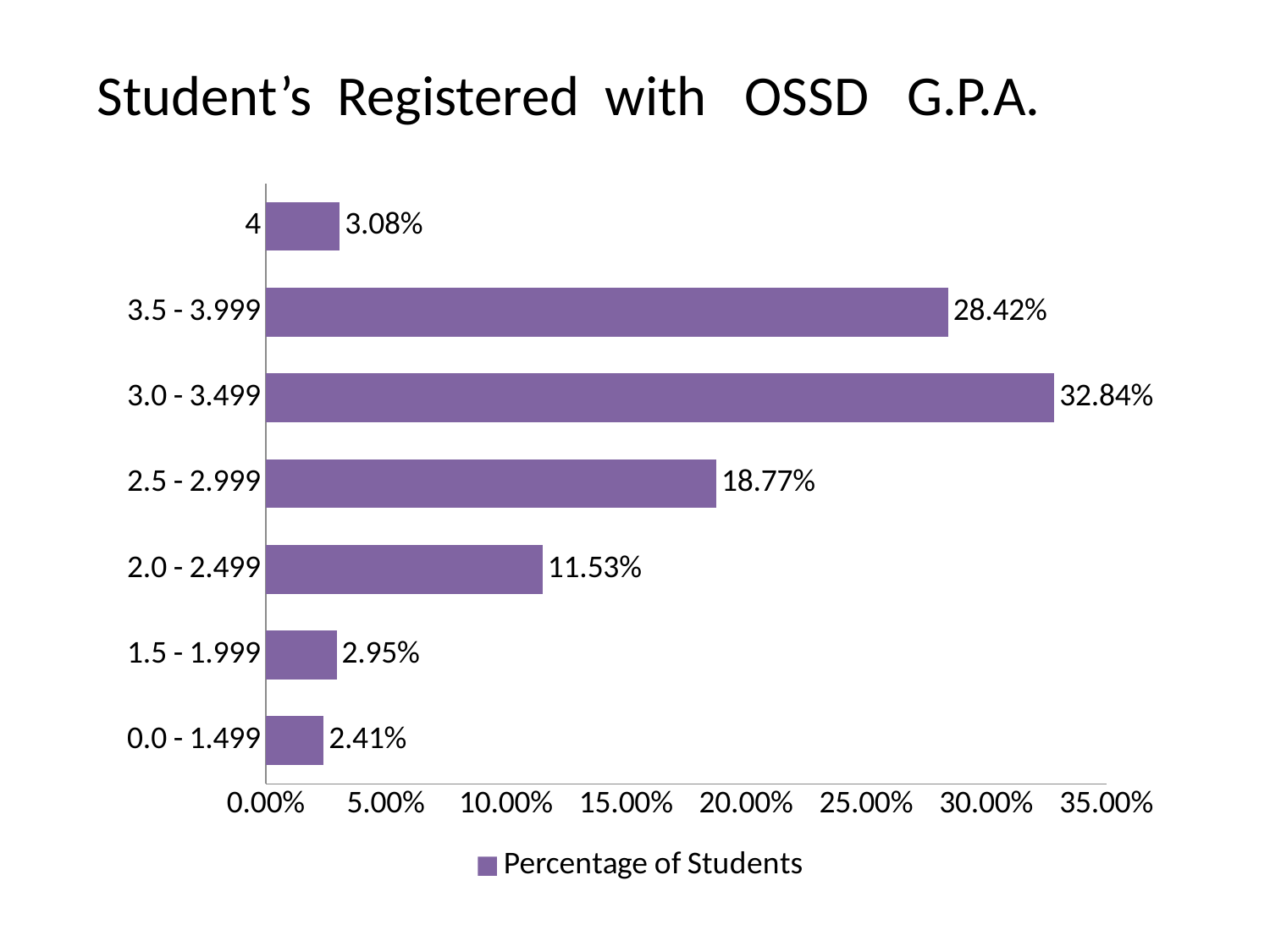
What percentage of students have a G.P.A. of 0.0 - 1.499? 2.41% What is the value for the 2.0 - 2.499 G.P.A. range? 11.53% Which has a larger percentage of students: 2.5 - 2.999 or 2.0 - 2.499? 2.5 - 2.999 How many G.P.A. ranges are shown in the chart? 7 What percentage of students have a G.P.A. of 3.0 - 3.499? 32.84% Is the value for the 3.5 - 3.999 range greater or less than 25.00%? greater Which G.P.A. range has the highest percentage of students? 3.0 - 3.499 What is the difference between the percentages for 3.0 - 3.499 and 3.5 - 3.999? 4.42% Which G.P.A. range has the lowest percentage of students? 0.0 - 1.499 How many series does the legend list? 1 What kind of chart is shown on the slide? bar chart What is the legend entry for the series in the chart? Percentage of Students